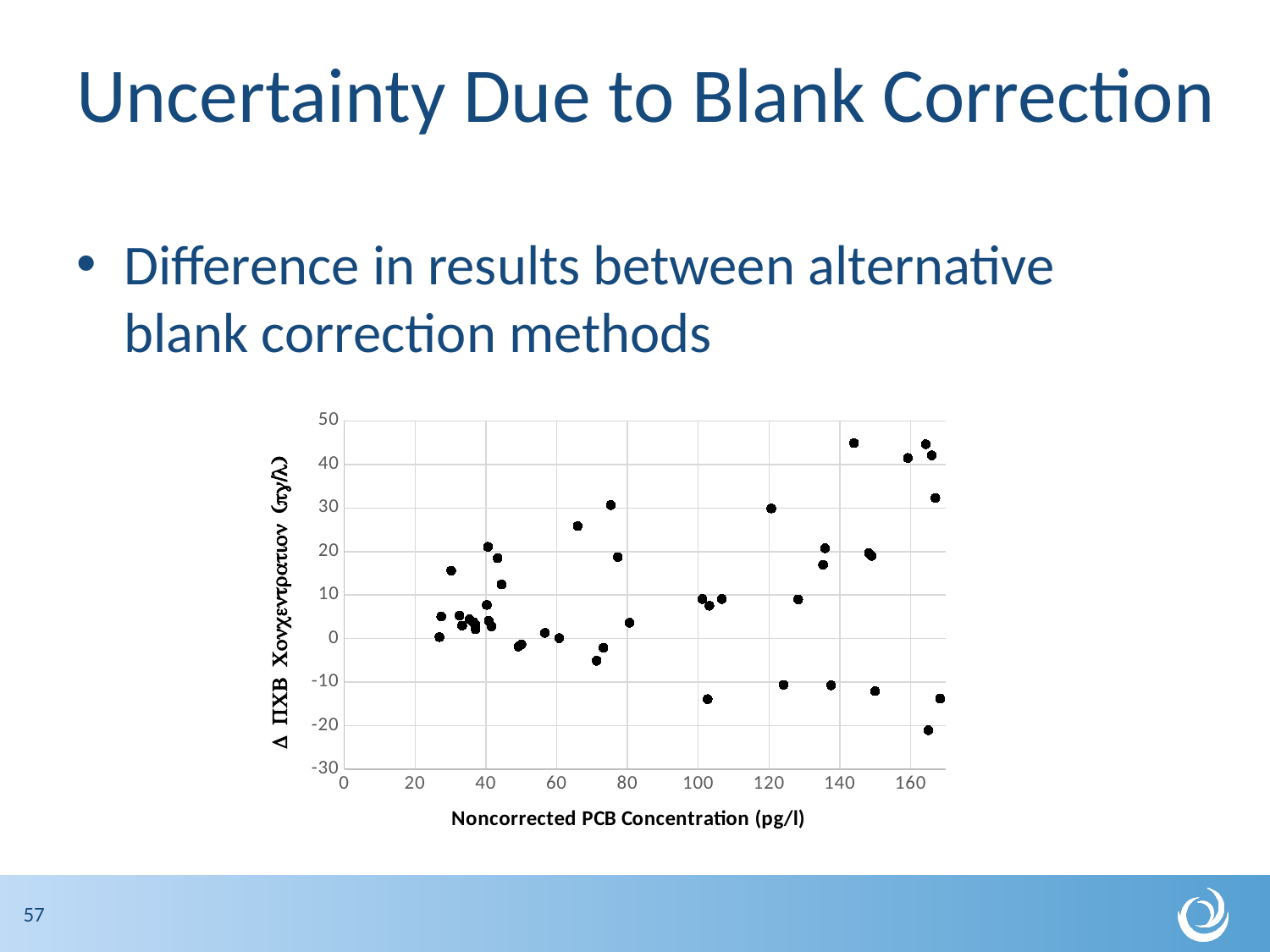
Is the highest plotted y value on the chart greater or less than 40? greater What is the highest value shown on the y axis of the chart? 50 What is the title of the x axis of the chart? Noncorrected PCB Concentration (pg/l) Is the smallest x value of any plotted point greater or less than 20? greater What is the lowest value shown on the y axis of the chart? -30 What kind of chart is shown on the slide? scatter plot What is the largest tick value shown on the x axis of the chart? 160